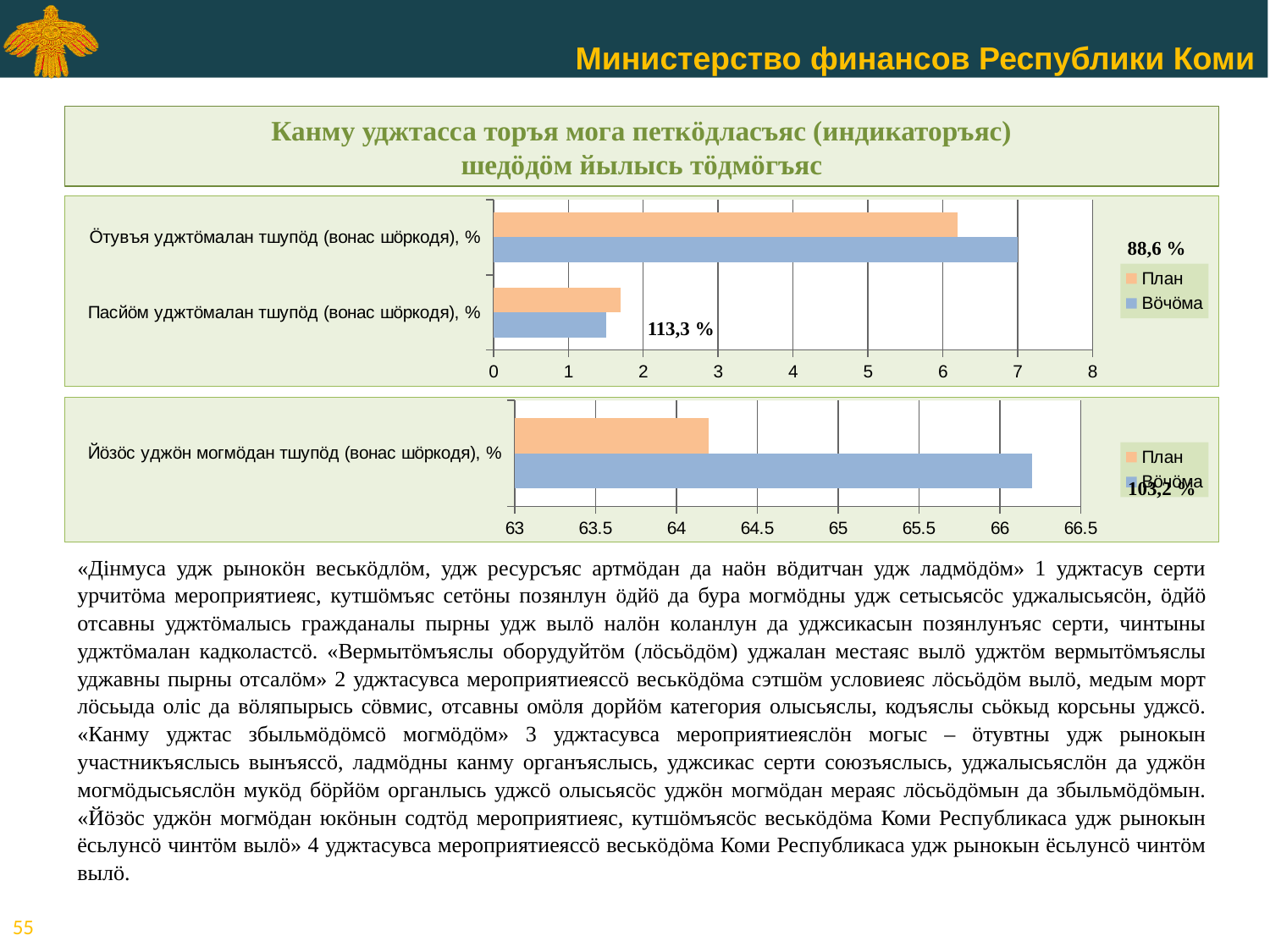
How many series does the legend of the top chart list? 2 In the bottom chart, is the План value for Йӧзӧс уджӧн могмӧдан тшупӧд greater or less than 65? less In the top chart, which category has the higher values, Ӧтувъя уджтӧмалан тшупӧд or Пасйӧм уджтӧмалан тшупӧд? Ӧтувъя уджтӧмалан тшупӧд (вонас шӧркодя), % How many categories does the bottom chart show? 1 In the top chart, is the Вӧчӧма value for Пасйӧм уджтӧмалан тшупӧд greater or less than 2? less In the bottom chart, is the Вӧчӧма value for Йӧзӧс уджӧн могмӧдан тшупӧд greater or less than 66? greater In the top chart, which colour represents the План series? orange In the top chart, for Ӧтувъя уджтӧмалан тшупӧд, which series has the larger value, План or Вӧчӧма? Вӧчӧма In the bottom chart, which series has the larger value, План or Вӧчӧма? Вӧчӧма How many categories does the top chart show? 2 What kind of chart is the top chart on the slide? bar chart